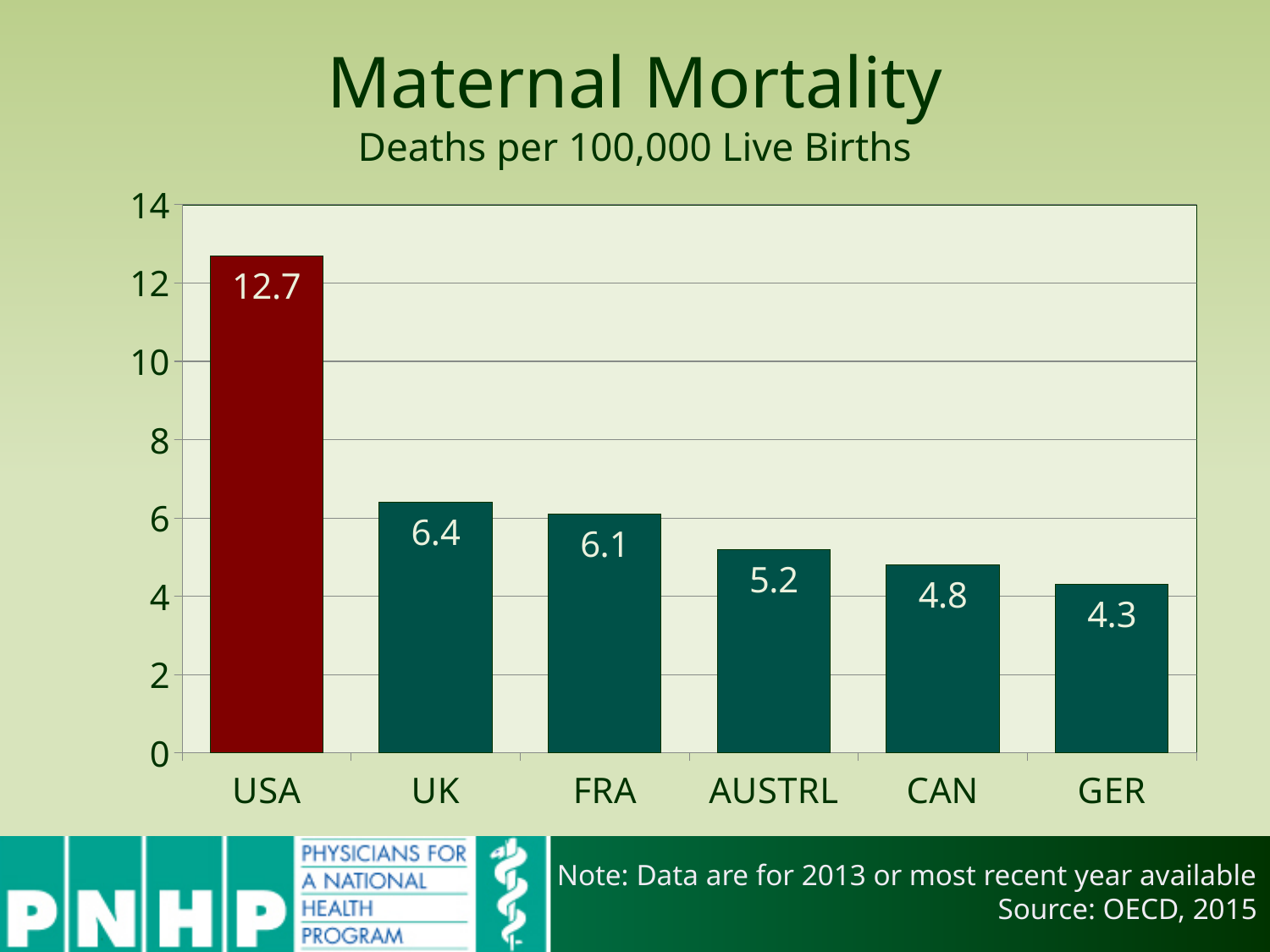
Which country has the highest maternal mortality on the chart? USA What is the difference between the FRA value and the GER value? 1.8 What kind of chart is shown on the slide? bar chart Which country has the lowest maternal mortality on the chart? GER What is the value shown for CAN? 4.8 What is the difference between the USA value and the UK value? 6.3 What is the subtitle of the chart describing the unit of measurement? Deaths per 100,000 Live Births What is the maternal mortality value for the USA? 12.7 What is the value shown for AUSTRL? 5.2 Is the value for USA greater or less than 10? greater How many countries are shown on the chart? 6 Which has a higher value, UK or FRA? UK